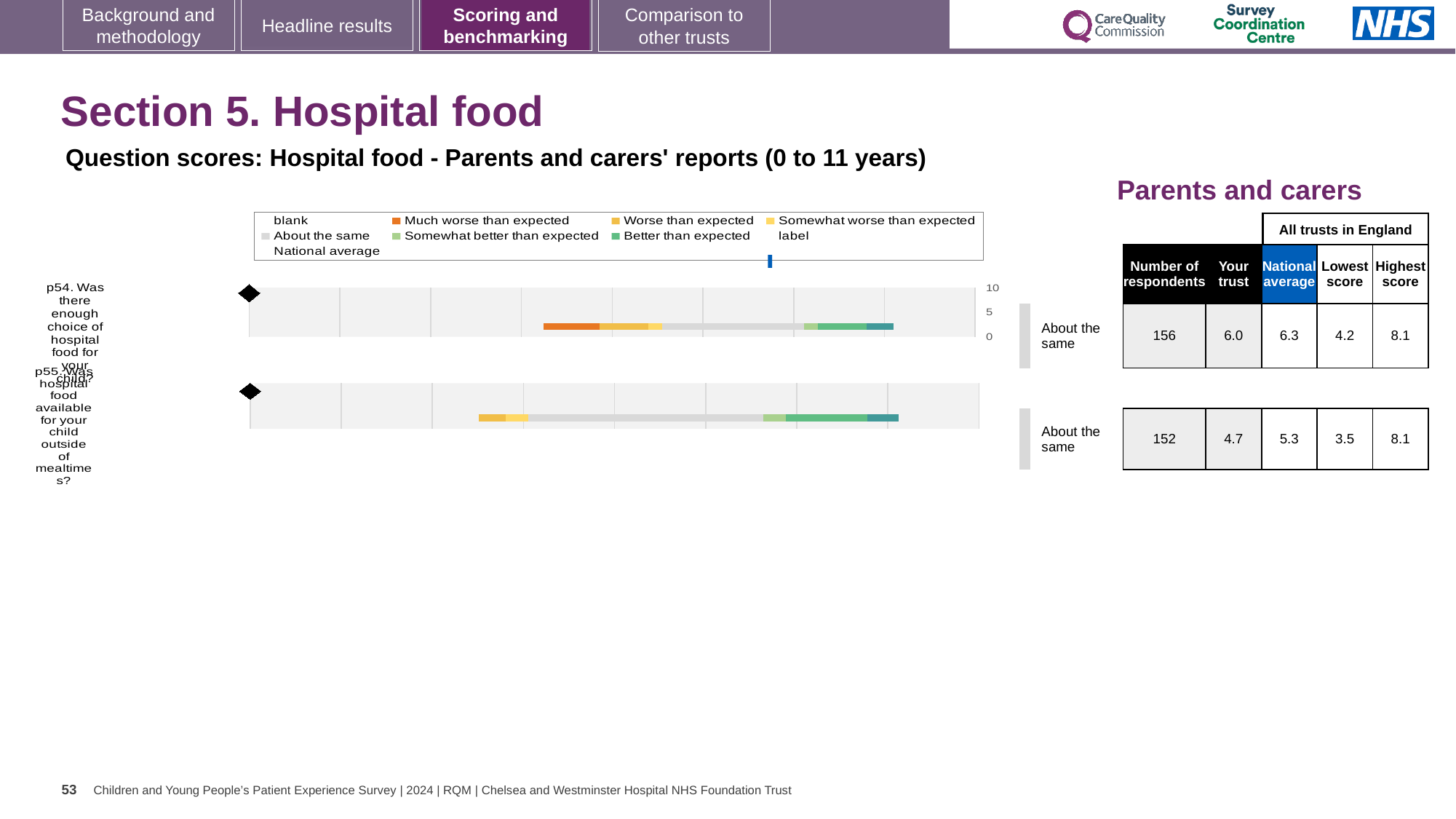
Which question has the higher 'Your trust' score, p54 or p55? p54 What is the lowest score among all trusts in England for p55 (food available outside of mealtimes)? 3.5 What is the highest score among all trusts in England for p54 (enough choice of hospital food)? 8.1 What is the 'Your trust' score for p54 (enough choice of hospital food)? 6.0 What is the number of respondents for p54 (enough choice of hospital food)? 156 Which question has the larger number of respondents? p54 What kind of chart is used to show the question scores for hospital food? Bar chart What is the national average score for p55 (food available outside of mealtimes)? 5.3 What is the difference between the national average and the 'Your trust' score for p55 (food available outside of mealtimes)? 0.6 What benchmark category is shown for both p54 and p55? About the same How many survey questions are plotted in the hospital food chart? 2 Is the 'Your trust' score for p54 greater or less than 5? greater